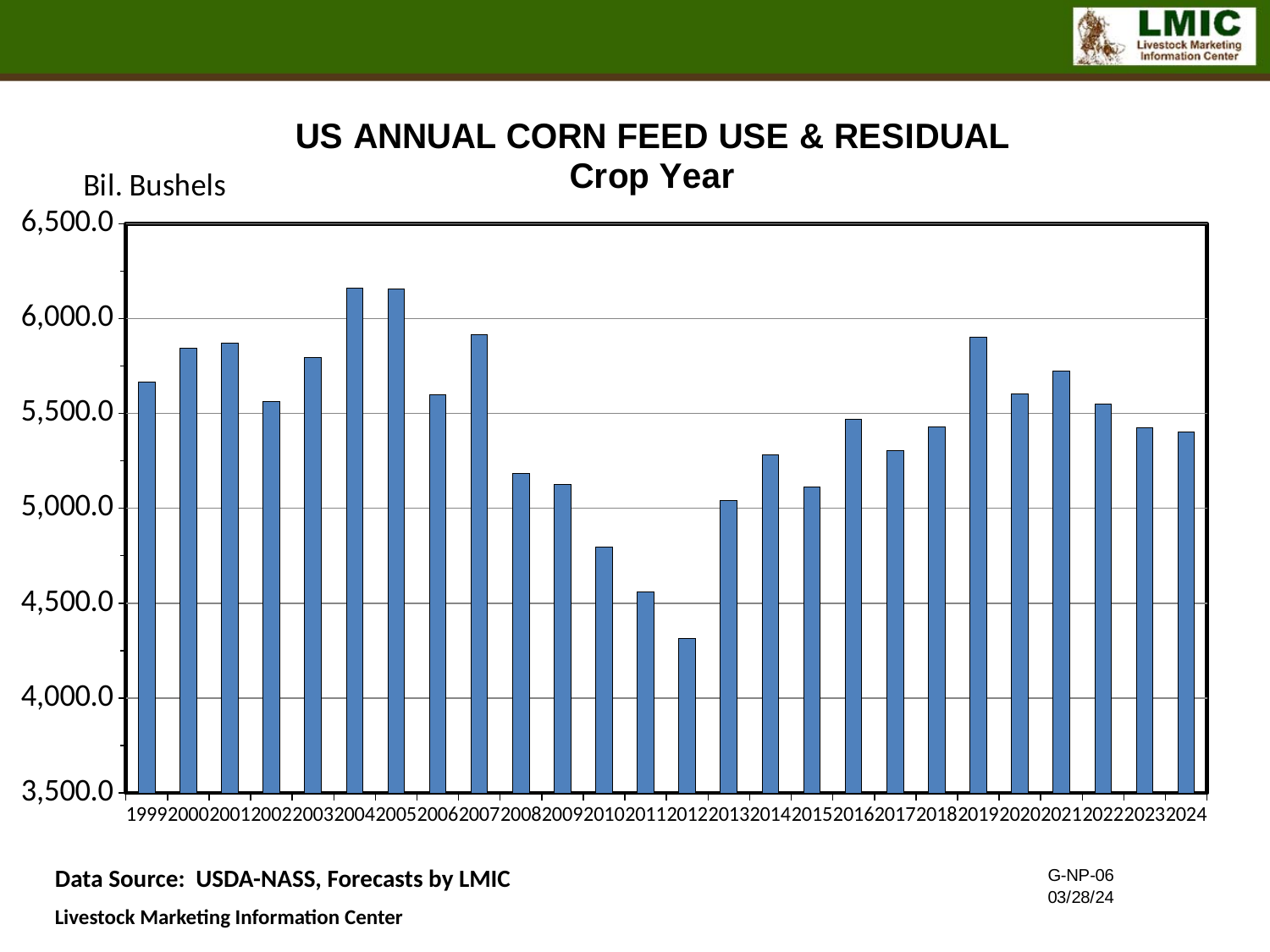
Which crop year has the lowest corn feed use & residual? 2012 Is the value for 2019 greater or less than 5,500? greater Is the value for 2021 greater or less than 5,500? greater Which is larger, the value for 2019 or the value for 2020? 2019 Is the value for 2012 greater or less than 4,500? less What unit is shown on the y-axis label of the chart? Bil. Bushels Do the values rise or fall from 2007 to 2012? fall How many crop years are plotted on the chart? 26 Which is larger, the value for 2010 or the value for 2011? 2010 What kind of chart is shown on the slide? bar chart